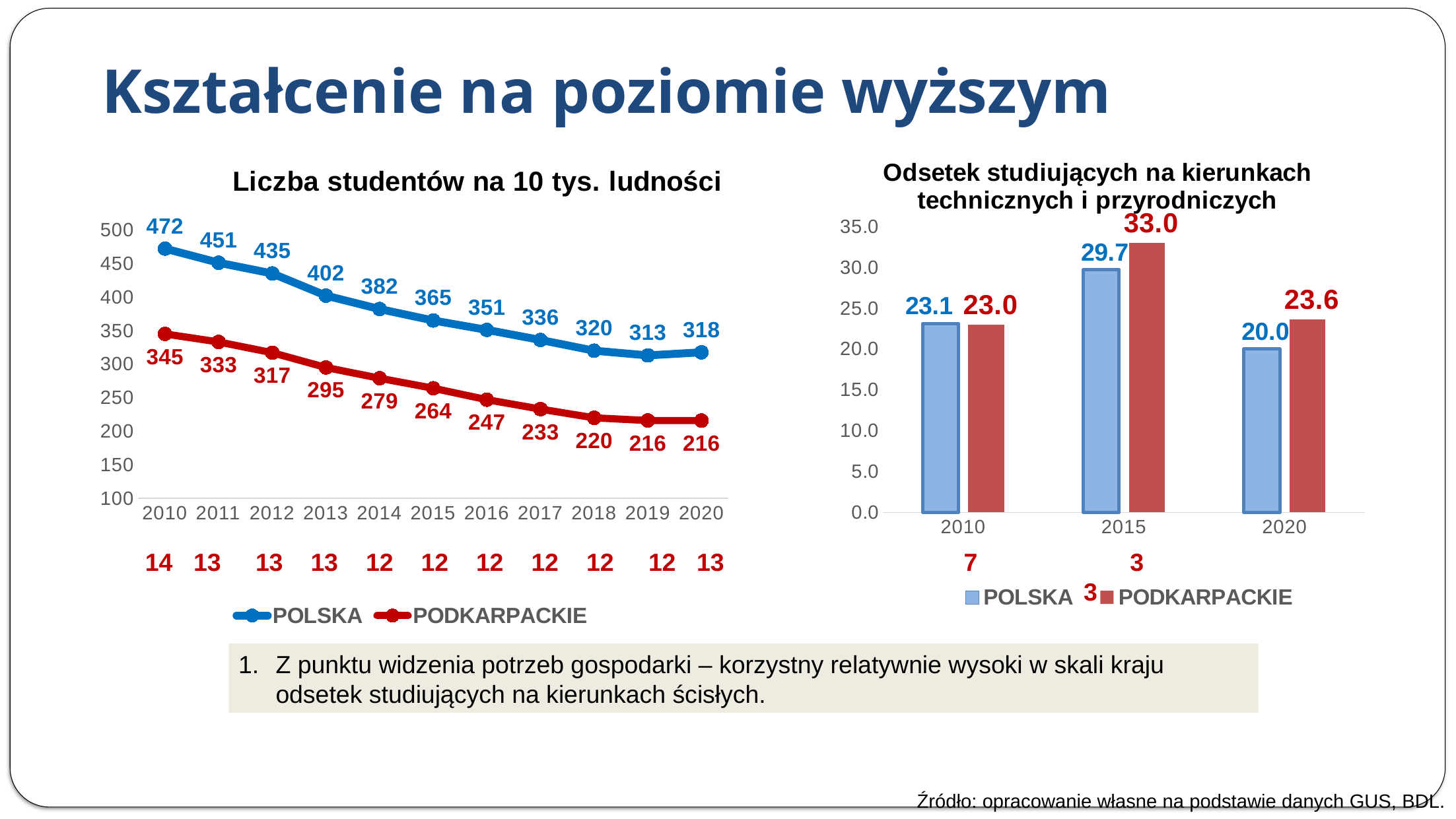
In the chart 'Liczba studentów na 10 tys. ludności', in which year is the POLSKA series lowest? 2019 What kind of chart is 'Liczba studentów na 10 tys. ludności'? line chart In the chart 'Odsetek studiujących na kierunkach technicznych i przyrodniczych', what is the value for PODKARPACKIE in 2015? 33.0 In the chart 'Odsetek studiujących na kierunkach technicznych i przyrodniczych', what is the value for POLSKA in 2020? 20.0 In the chart 'Liczba studentów na 10 tys. ludności', how many years are shown on the x axis? 11 In the chart 'Liczba studentów na 10 tys. ludności', what is the value for POLSKA in 2010? 472 In the chart 'Odsetek studiujących na kierunkach technicznych i przyrodniczych', which is larger in 2020, POLSKA or PODKARPACKIE? PODKARPACKIE In the chart 'Liczba studentów na 10 tys. ludności', what is the value for PODKARPACKIE in 2016? 247 In the chart 'Liczba studentów na 10 tys. ludności', what is the difference between POLSKA and PODKARPACKIE in 2020? 102 In the chart 'Odsetek studiujących na kierunkach technicznych i przyrodniczych', what is the difference between PODKARPACKIE and POLSKA in 2015? 3.3 How many series does the legend of the chart 'Odsetek studiujących na kierunkach technicznych i przyrodniczych' list? 2 In the chart 'Liczba studentów na 10 tys. ludności', does the PODKARPACKIE series generally rise or fall from 2010 to 2020? fall